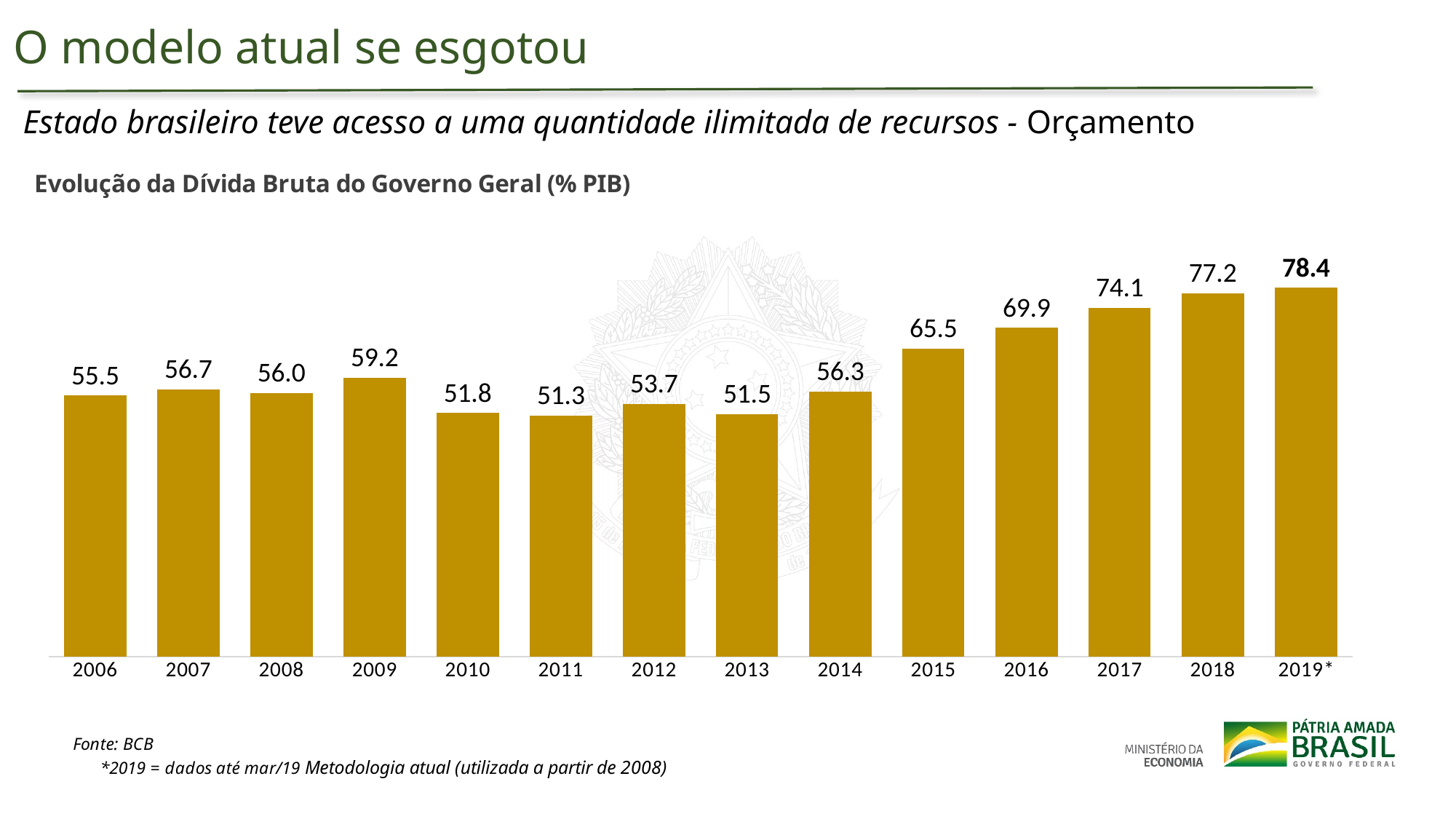
What is the value for 2019* in the chart? 78.4 What is the title of the chart? Evolução da Dívida Bruta do Governo Geral (% PIB) What is the difference between the values for 2018 and 2017? 3.1 Do the values rise or fall from 2013 to 2019*? rise How many years are shown on the x axis of the chart? 14 Which year has the lowest value in the chart? 2011 What kind of chart is shown on the slide? bar chart What is the value for 2015 in the chart? 65.5 What is the value for 2011 in the chart? 51.3 Which is larger, the value for 2009 or the value for 2014? 2009 Which year has the highest value in the chart? 2019* What is the difference between the values for 2019* and 2006? 22.9